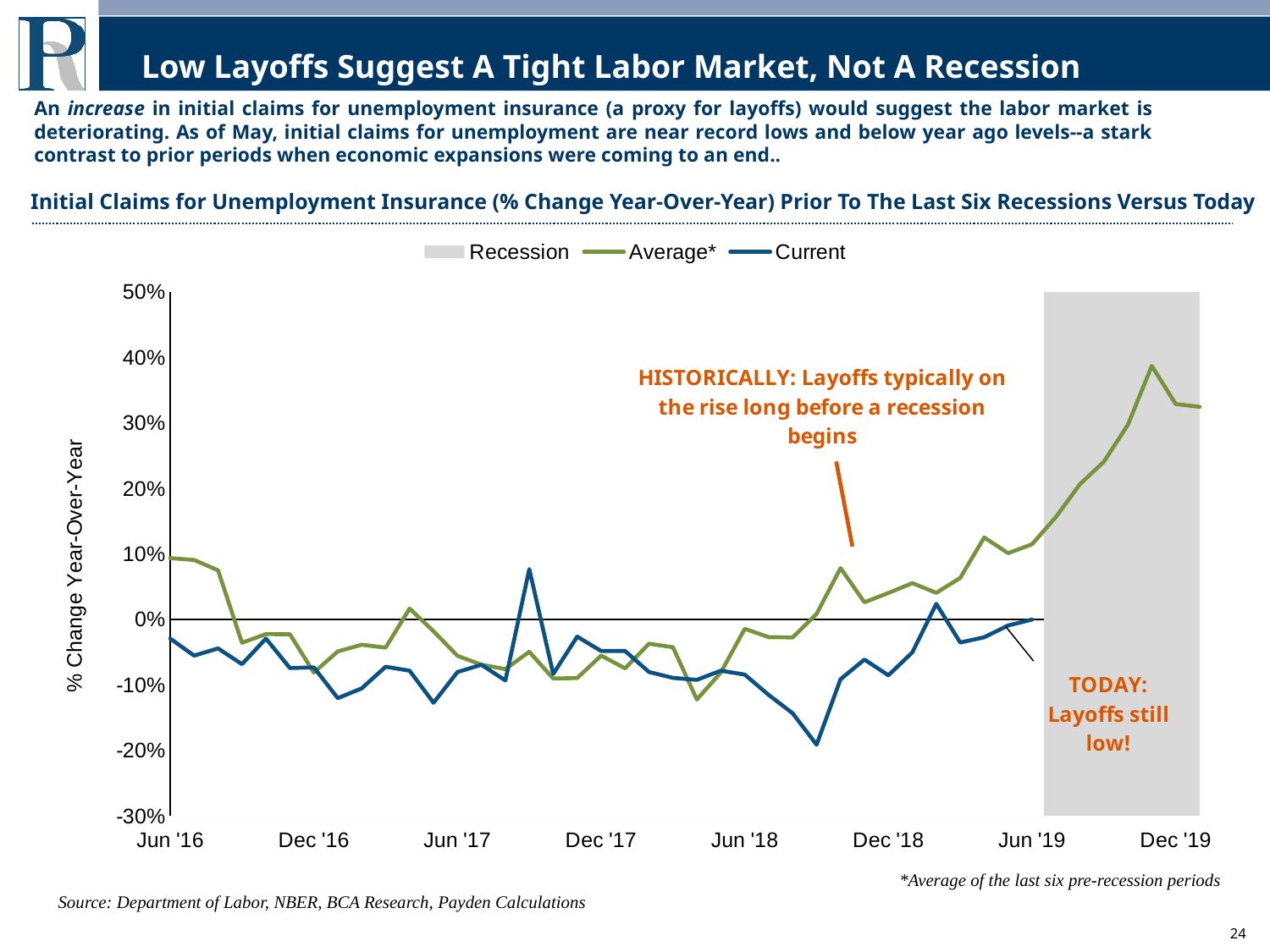
Which series reaches the lowest value anywhere on the chart, Average* or Current? Current Is the value of the Average* line at Jun '19 greater or less than 10%? greater Which series reaches the highest value anywhere on the chart, Average* or Current? Average* Around Oct '18, which line is higher, Average* or Current? Average* Is the value of the Current line at Jun '16 greater or less than 0%? less What are the names of the two line series in the legend? Average* and Current Does the Average* line rise or fall between Jun '19 and its peak near Nov '19? Rise What kind of chart is shown on the slide? Line chart How many entries does the chart legend list? 3 Is the value of the Average* line at Dec '19 greater or less than 30%? greater What is the label on the vertical axis of the chart? % Change Year-Over-Year